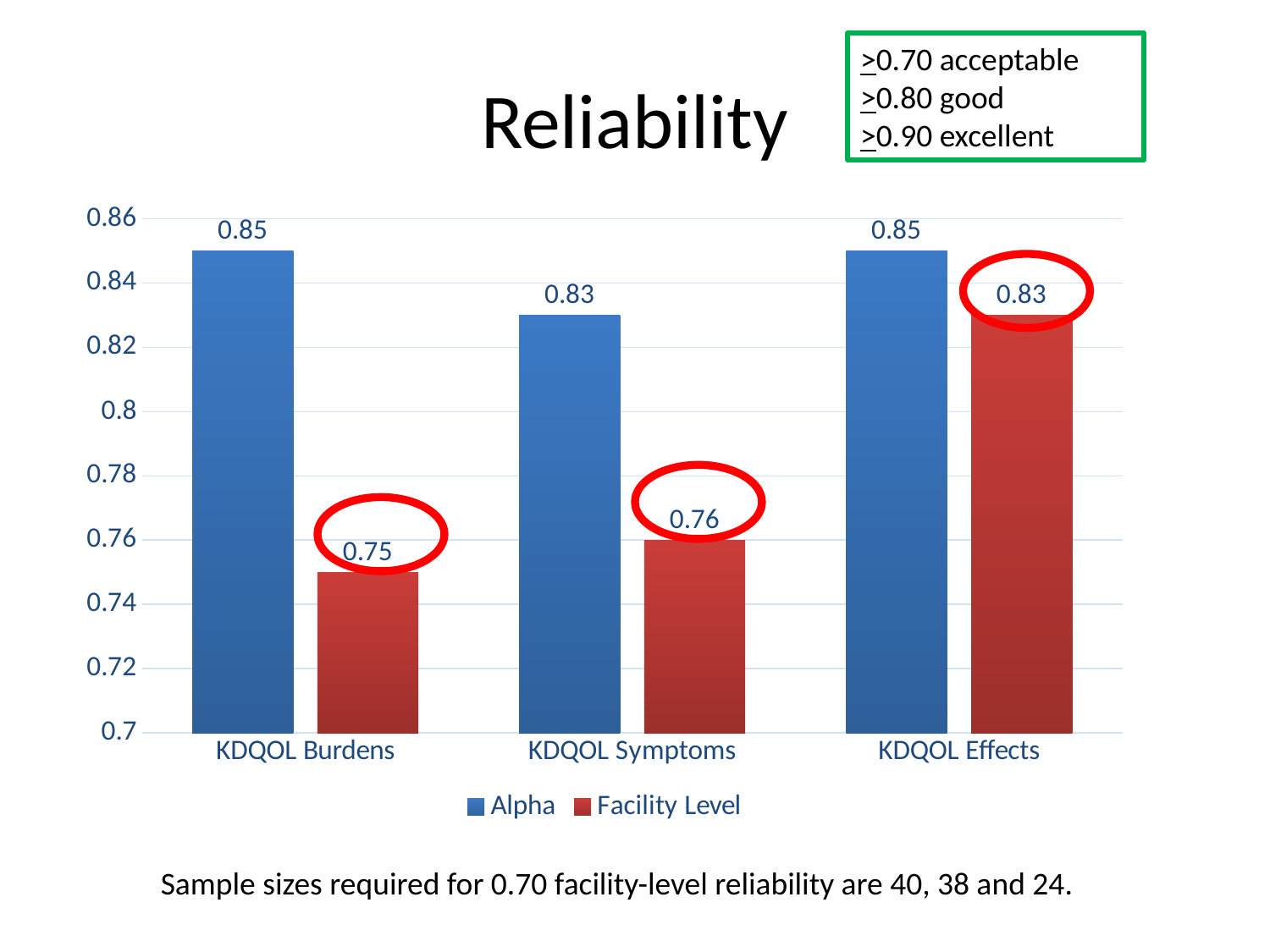
Is the Facility Level value for KDQOL Effects greater or less than 0.80? greater Which category has the lowest Facility Level value? KDQOL Burdens How many categories are shown on the x axis? 3 What is the difference between the Alpha and Facility Level values for KDQOL Burdens? 0.10 What is the Alpha value for KDQOL Burdens? 0.85 What is the Alpha value for KDQOL Symptoms? 0.83 How many series does the legend list? 2 What is the Facility Level value for KDQOL Symptoms? 0.76 Which category has the highest Facility Level value? KDQOL Effects What is the Facility Level value for KDQOL Effects? 0.83 What kind of chart is shown on the slide? Bar chart Which is larger for KDQOL Symptoms, the Alpha value or the Facility Level value? Alpha